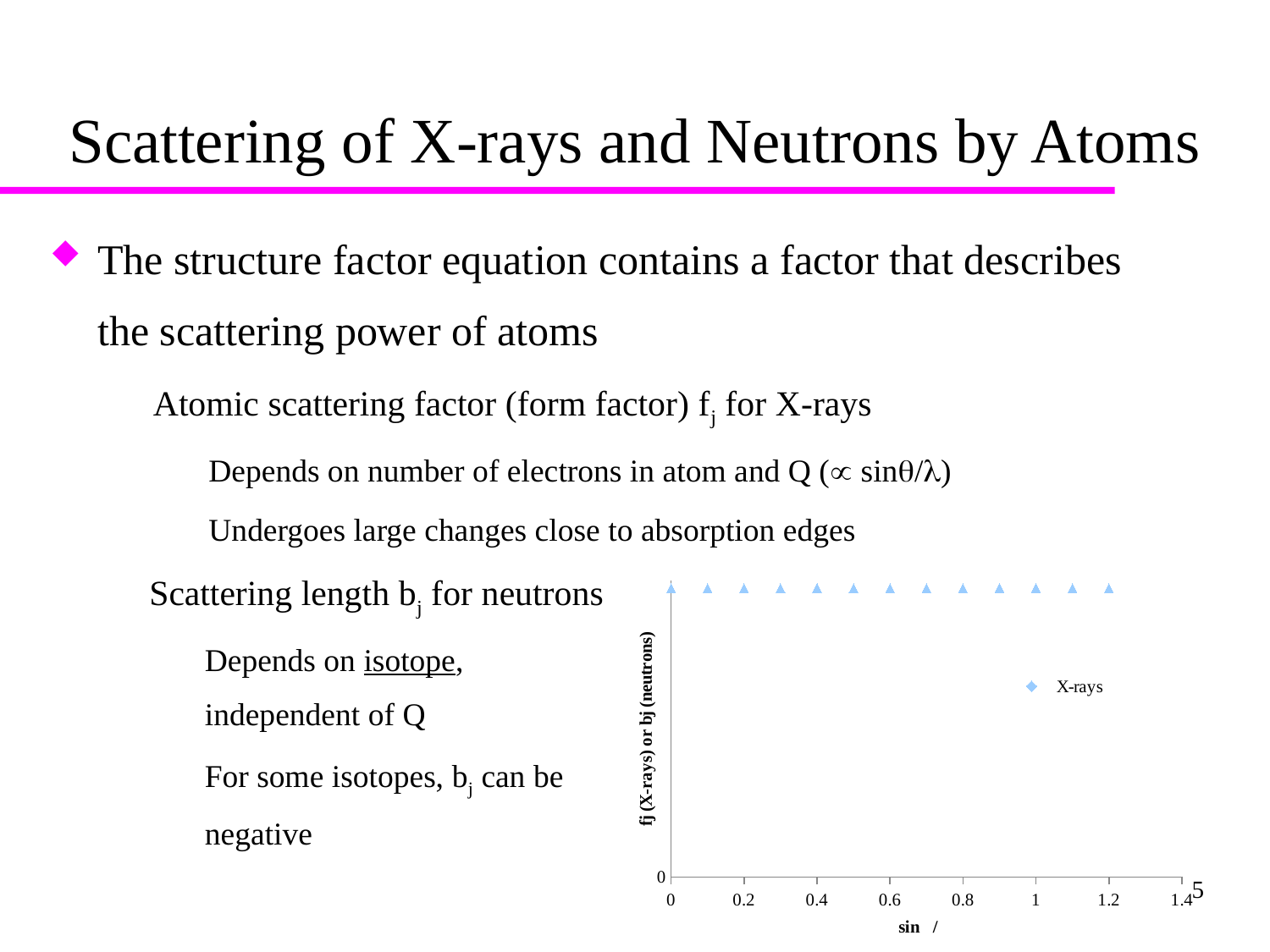
How many data points are plotted in the chart? 13 How many series does the chart's legend list? 1 What is the label on the chart's vertical axis? fj (X-rays) or bj (neutrons) What kind of chart is shown on the slide? scatter plot What is the name of the series listed in the chart's legend? X-rays Do the plotted values rise, fall, or stay constant as sin θ/λ increases along the x axis? stay constant What is the largest tick value shown on the chart's x axis? 1.4 Is the plotted value at sin θ/λ = 0.6 greater or less than 0? greater What is the smallest tick value shown on the chart's x axis? 0